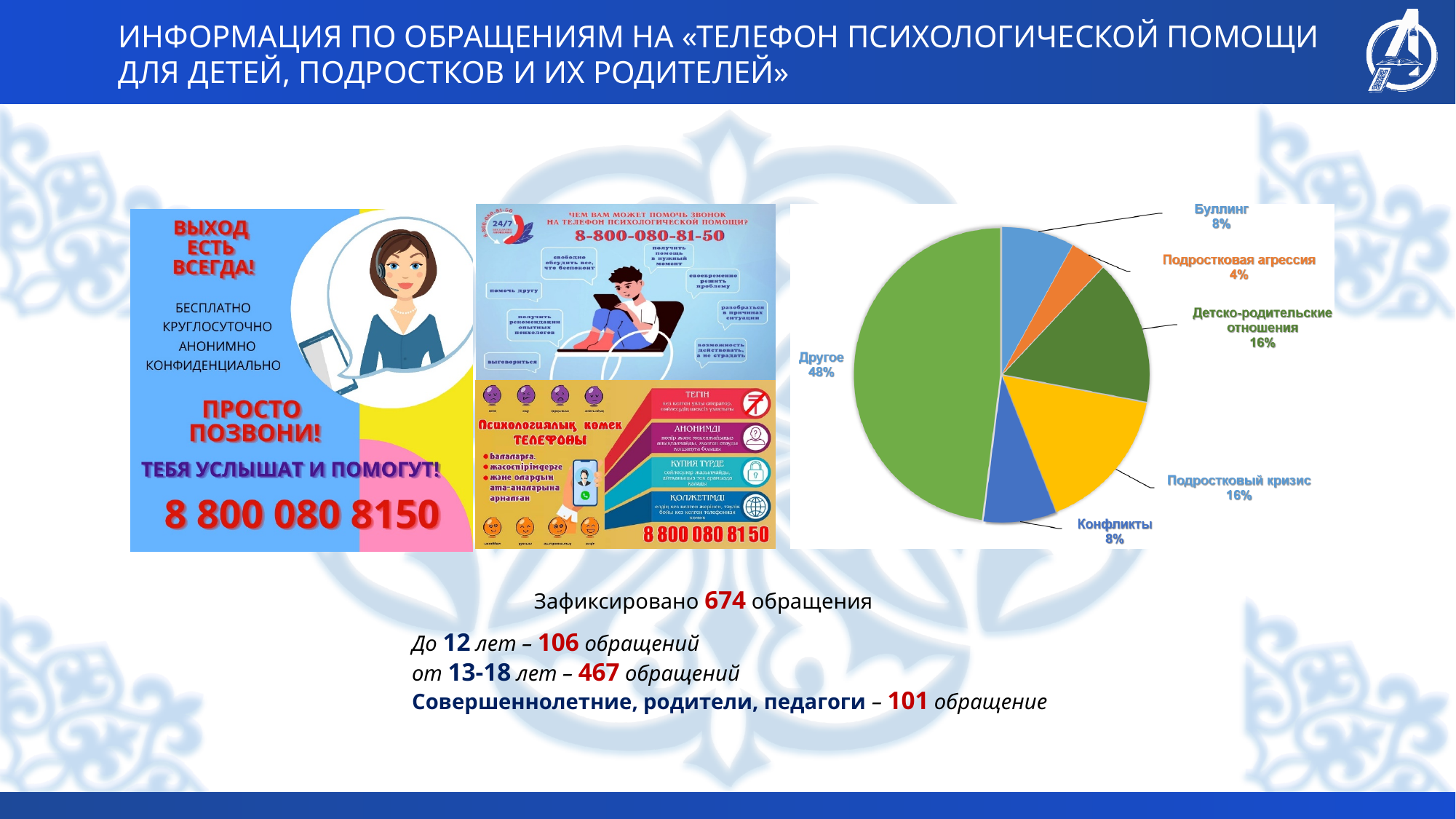
Which category has the largest slice in the pie chart? Другое What percentage is shown for «Подростковая агрессия» in the pie chart? 4% What kind of chart is shown on the slide? pie chart How many categories are shown in the pie chart? 6 What percentage is shown for «Детско-родительские отношения» in the pie chart? 16% What is the difference in percentage points between «Другое» and «Подростковый кризис»? 32 What percentage is shown for «Конфликты» in the pie chart? 8% What share of the pie chart does «Другое» represent? 48% What percentage is shown for «Буллинг» in the pie chart? 8% Which is larger in the pie chart: «Буллинг» or «Подростковая агрессия»? Буллинг What percentage is shown for «Подростковый кризис» in the pie chart? 16% Which category has the smallest slice in the pie chart? Подростковая агрессия